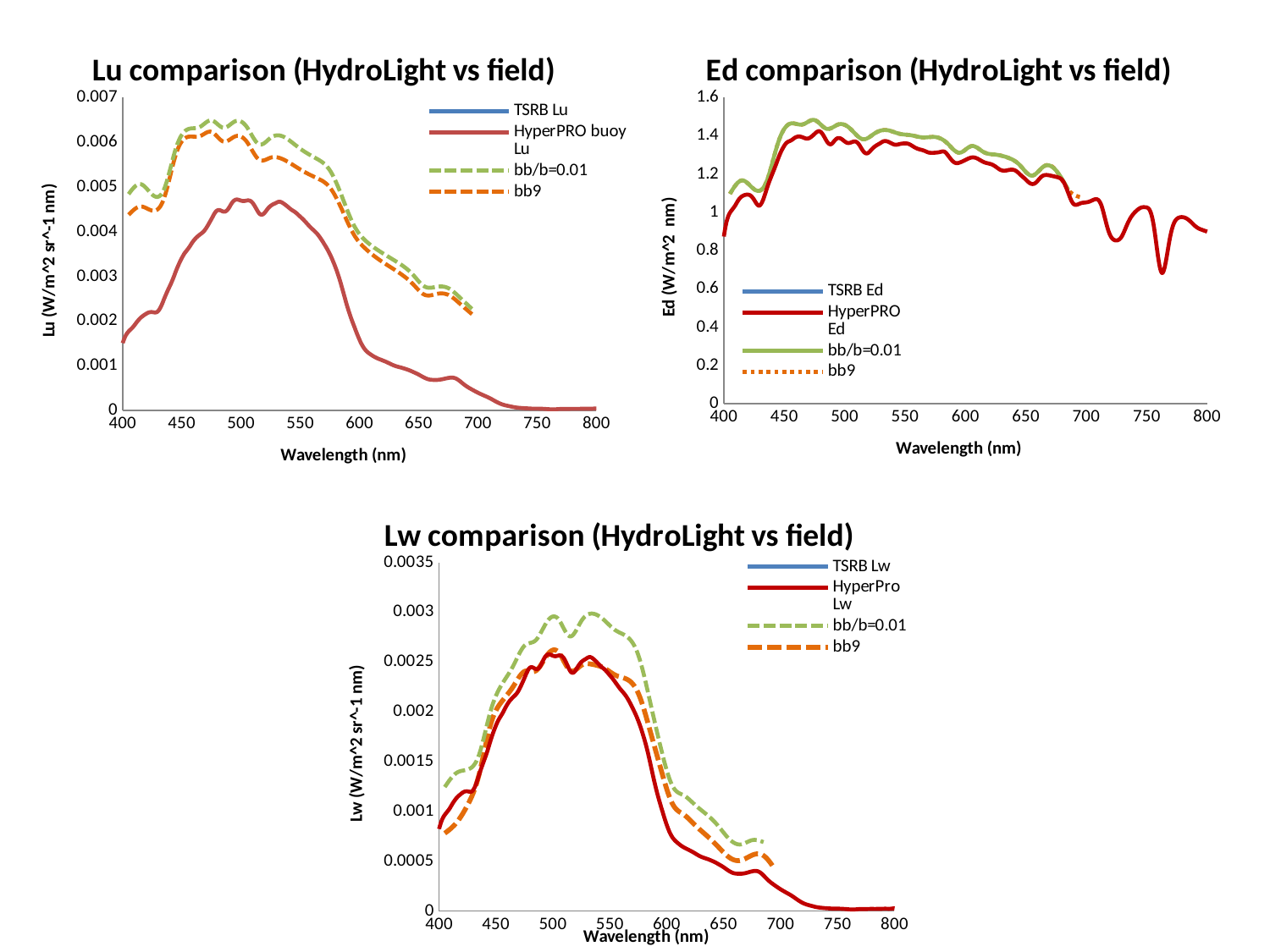
How many series does the legend of the "Ed comparison (HydroLight vs field)" chart list? 4 In the "Lu comparison (HydroLight vs field)" chart, is the value of HyperPRO buoy Lu at 700 nm greater or less than 0.001? less How many series does the legend of the "Lu comparison (HydroLight vs field)" chart list? 4 In the "Ed comparison (HydroLight vs field)" chart, is the value of HyperPRO Ed at 760 nm greater or less than 0.8? less What is the y-axis title of the "Ed comparison (HydroLight vs field)" chart? Ed (W/m^2 nm) In the "Lu comparison (HydroLight vs field)" chart, is the value of HyperPRO buoy Lu at 500 nm greater or less than 0.004? greater In the "Lw comparison (HydroLight vs field)" chart, which series is larger at 650 nm: bb/b=0.01 or HyperPro Lw? bb/b=0.01 What kind of chart is the "Lu comparison (HydroLight vs field)" chart? line chart In the "Ed comparison (HydroLight vs field)" chart, does the HyperPRO Ed series generally rise or fall between 550 nm and 800 nm? fall In the "Lu comparison (HydroLight vs field)" chart, which series is larger at 500 nm: bb/b=0.01 or HyperPRO buoy Lu? bb/b=0.01 What is the x-axis title of the "Lw comparison (HydroLight vs field)" chart? Wavelength (nm)